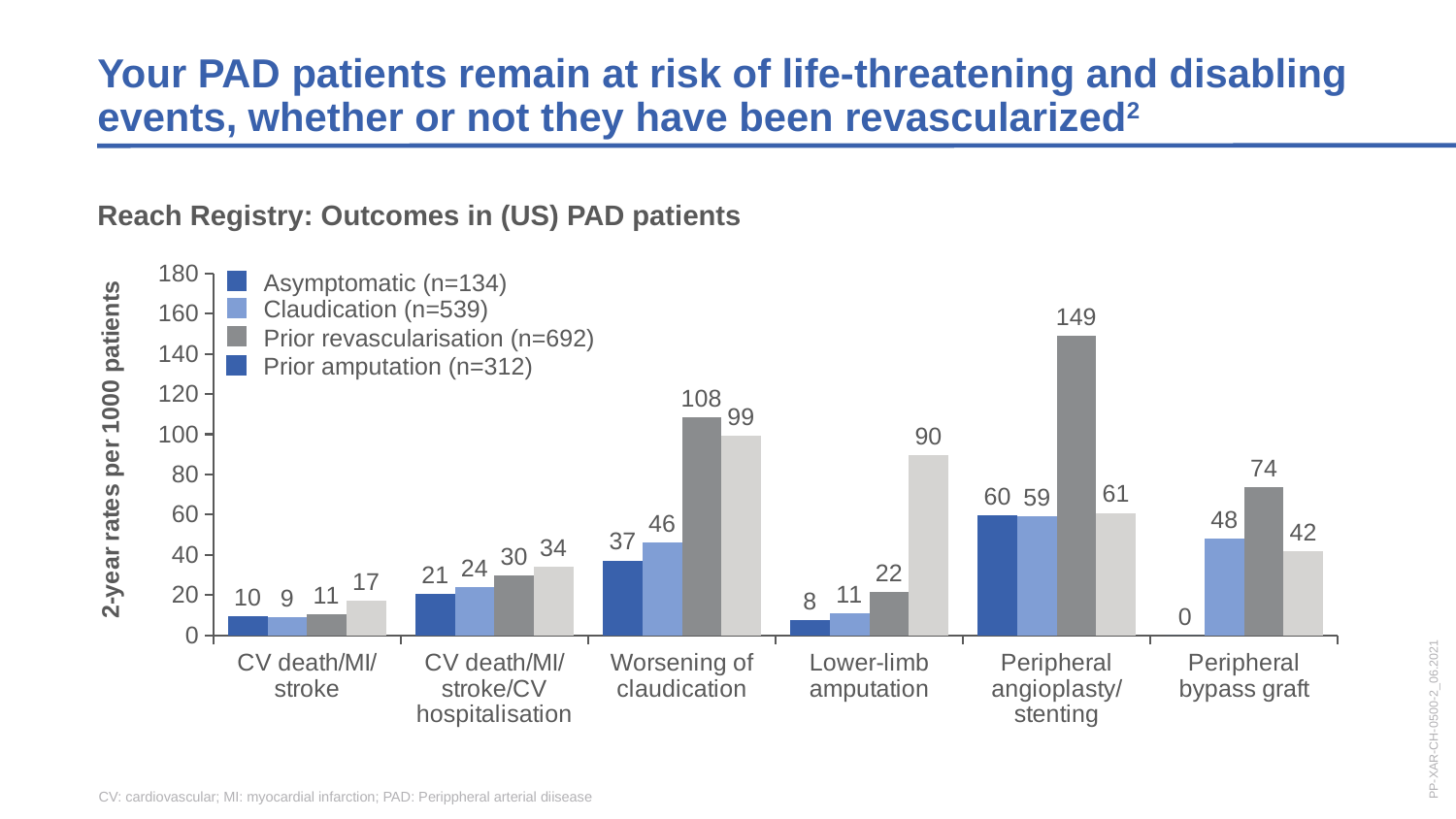
What is the label of the y axis? 2-year rates per 1000 patients What is the difference between the Prior revascularisation and Claudication values in the Worsening of claudication category? 62 What is the 2-year rate per 1000 patients for Prior revascularisation in the Peripheral angioplasty/stenting category? 149 What kind of chart is shown on the slide? Bar chart What is the value for Prior amputation in the Lower-limb amputation category? 90 In the Lower-limb amputation category, which is larger: the Prior amputation value or the Prior revascularisation value? Prior amputation What is the value for Asymptomatic patients in the Worsening of claudication category? 37 How many series does the legend list? 4 Which category has the highest value for the Prior revascularisation series? Peripheral angioplasty/stenting What is the value for Claudication in the Peripheral bypass graft category? 48 Which category has the lowest value for the Asymptomatic series? Peripheral bypass graft How many outcome categories are shown on the x axis? 6